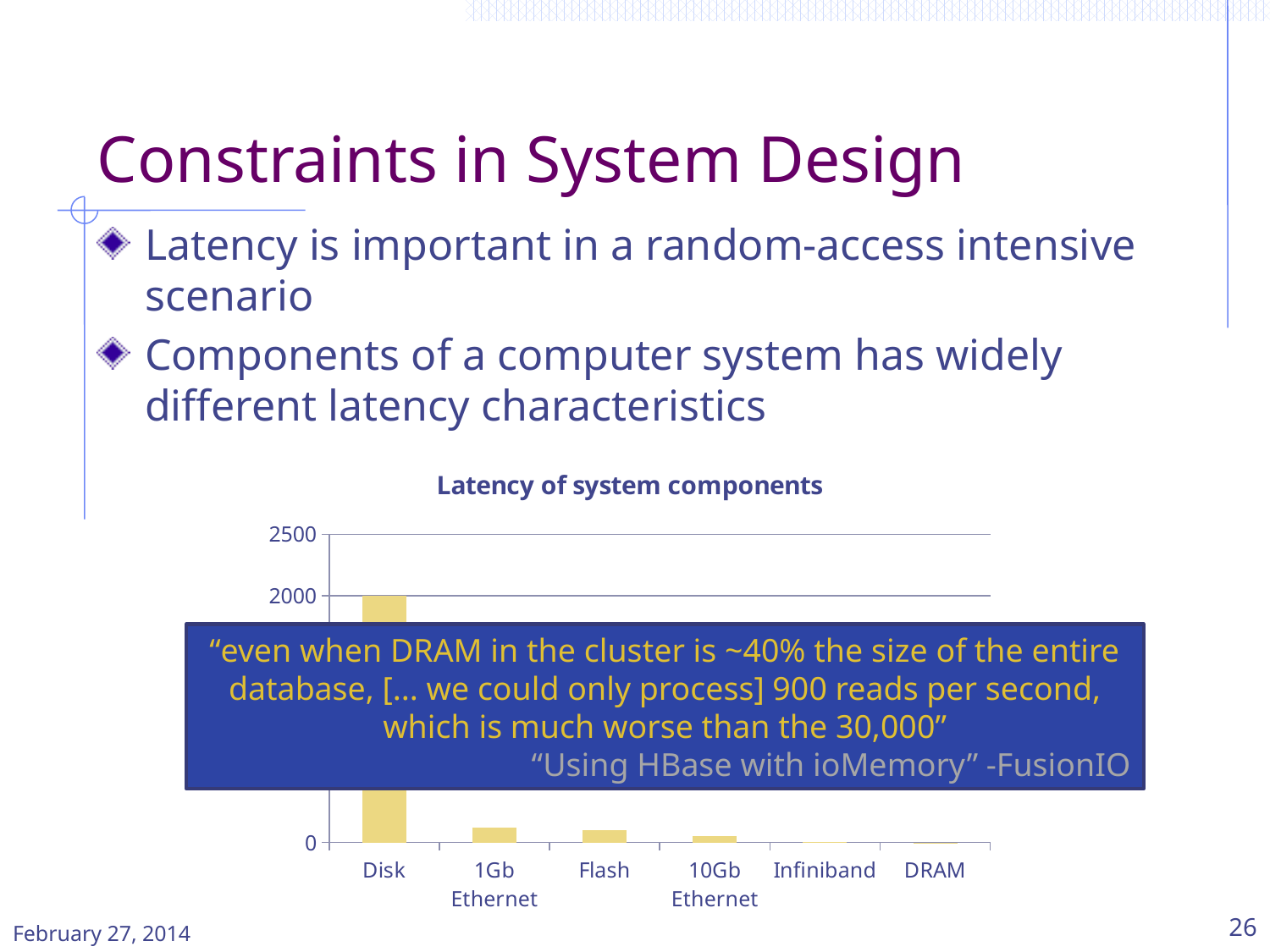
Is the latency value for Disk greater or less than 1000? greater What kind of chart is shown on the slide? bar chart Do the latency values rise or fall moving from left to right along the x axis? fall Which system component has the highest latency in the chart? Disk Is the latency value for Flash greater or less than 2000? less Which has the larger latency, 1Gb Ethernet or 10Gb Ethernet? 1Gb Ethernet How many system components are plotted on the x axis of the chart? 6 Is the latency value for 1Gb Ethernet greater or less than 2000? less What is the highest value shown on the chart's y axis? 2500 Which has the larger latency, Disk or Flash? Disk Which has the larger latency, Flash or 10Gb Ethernet? Flash What is the title of the chart? Latency of system components